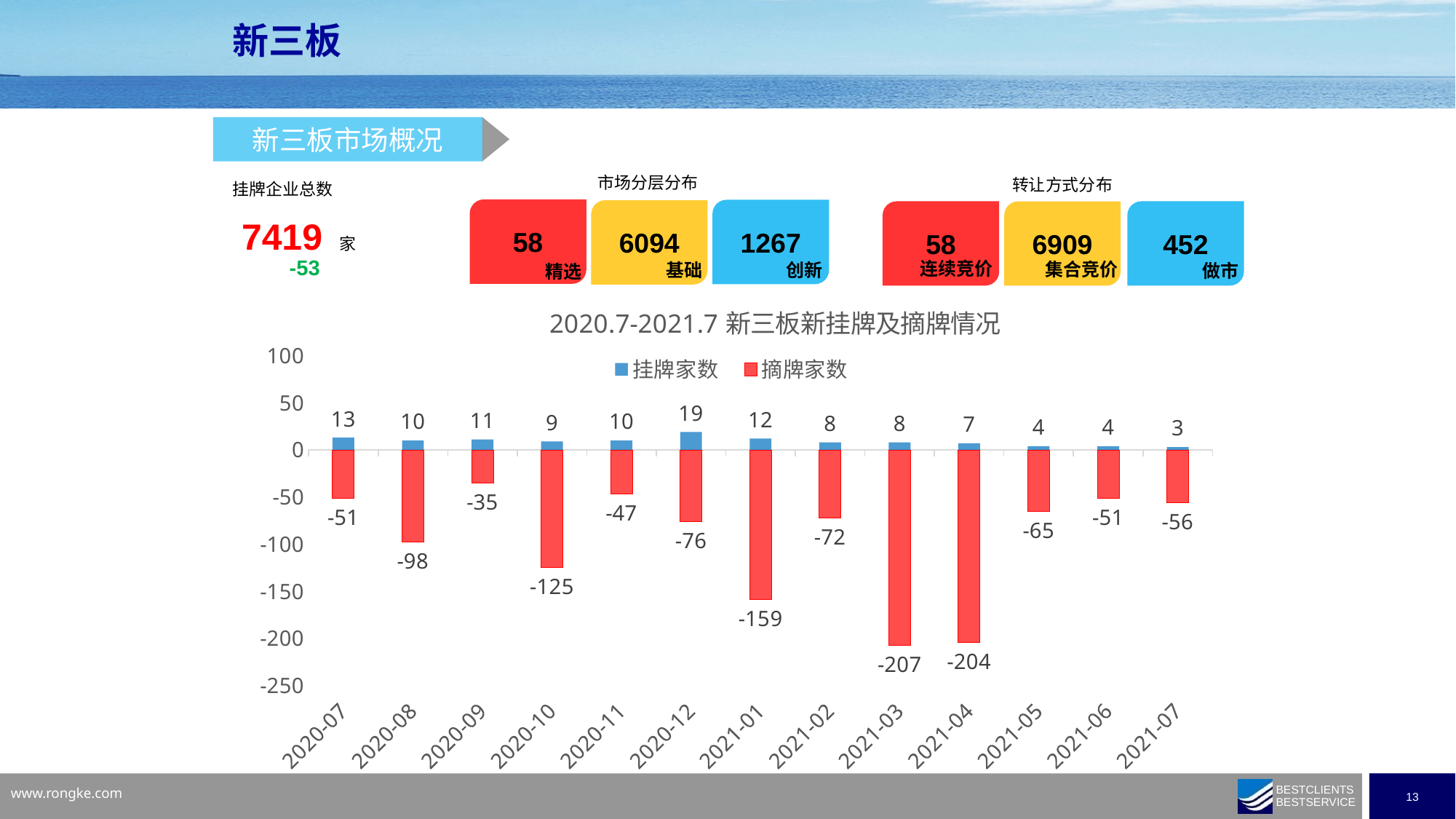
What is the title of the chart? 2020.7-2021.7 新三板新挂牌及摘牌情况 What is the 挂牌家数 value for 2020-12? 19 What is the 摘牌家数 value for 2021-03? -207 Which month has the highest 挂牌家数 value? 2020-12 What is the difference between the 挂牌家数 values for 2020-07 and 2021-07? 10 What type of chart is shown on the slide? bar chart Which month has the smallest 摘牌家数 magnitude (closest to zero)? 2020-09 How many months are shown on the x axis of the chart? 13 Which month has the lowest 挂牌家数 value? 2021-07 Is the 挂牌家数 value for 2020-12 larger than the 挂牌家数 value for 2021-01? Yes What is the 摘牌家数 value for 2020-10? -125 How many series does the chart legend list? 2